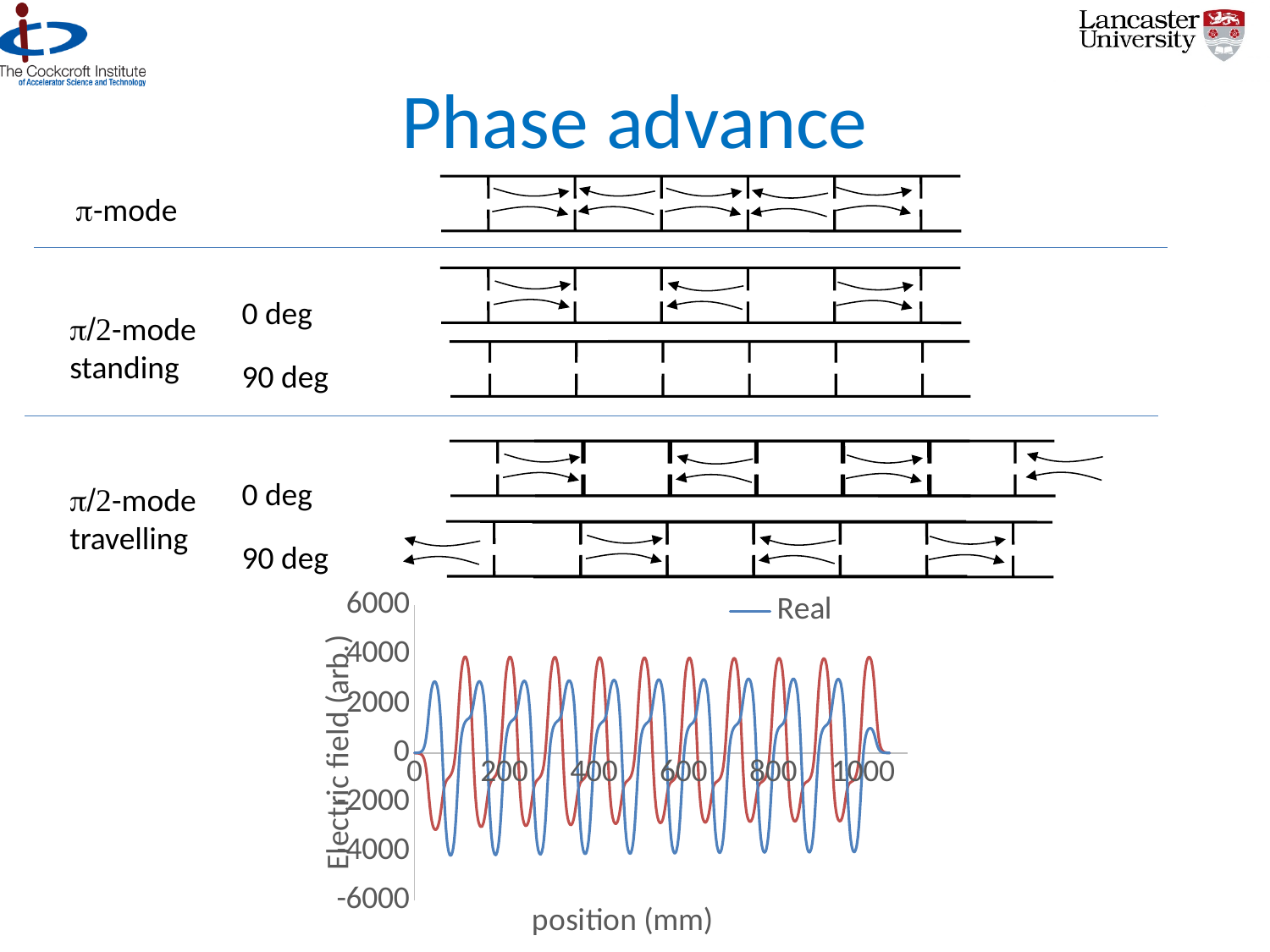
How many lines are plotted in the chart? 2 Do the plotted values rise steadily, fall steadily, or oscillate along the x axis? oscillate What is the x-axis title of the chart? position (mm) Are the peaks of the blue line greater or less than 2000? greater What is the lowest value shown on the chart's y axis? -6000 Which line reaches higher peaks, the red line or the blue line? red line Are the troughs of the red line greater or less than -4000? greater What is the highest value shown on the chart's y axis? 6000 What is the largest tick value shown on the chart's x axis? 1000 What is the only series name shown in the chart's legend? Real Are the peaks of the blue line greater or less than 4000? less What kind of chart is shown at the bottom of the slide? line chart